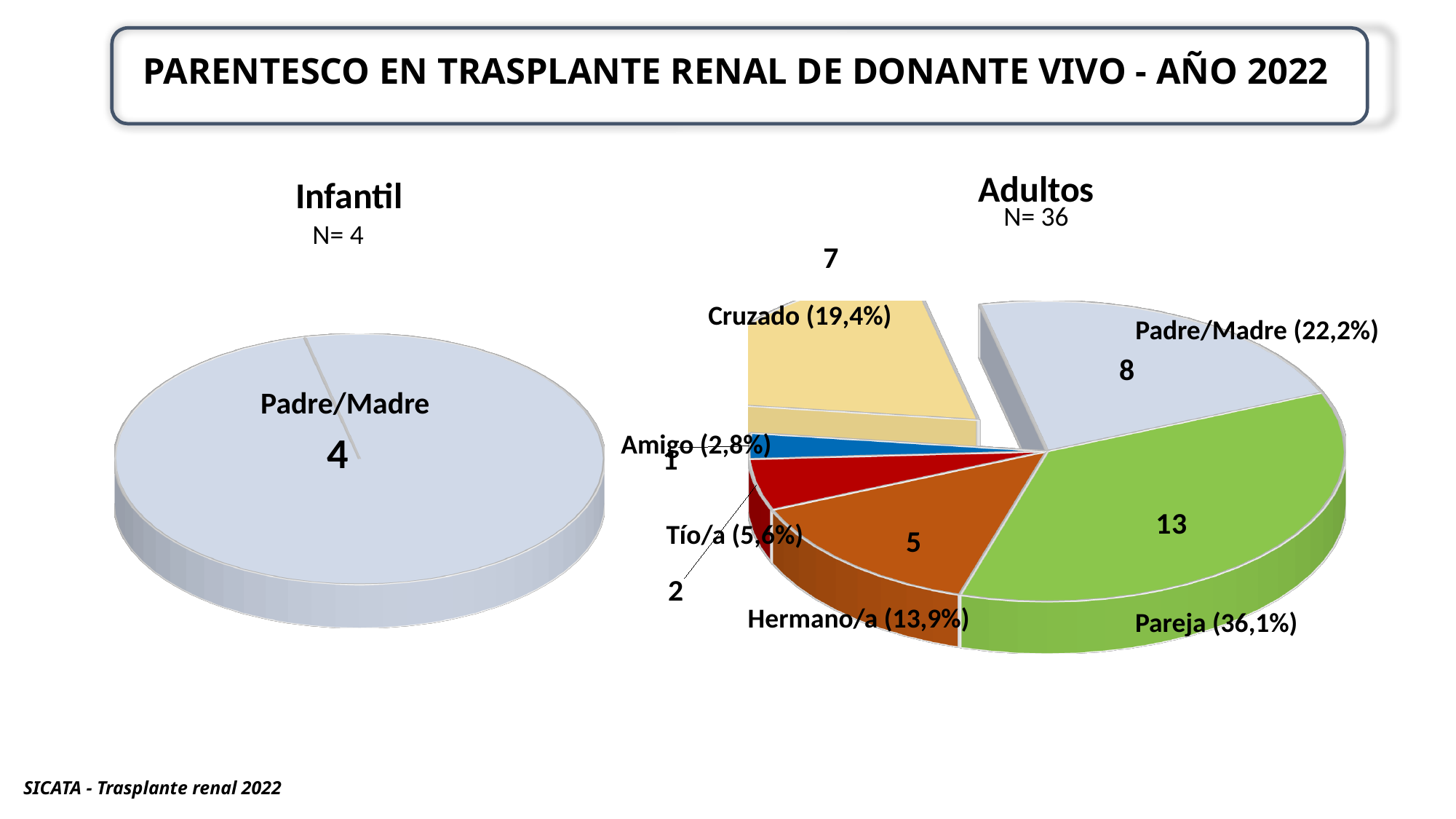
What is the N value stated for the Adultos chart? N= 36 In the Adultos pie chart, what is the difference between the values for Pareja and Padre/Madre? 5 In the Adultos pie chart, which is larger, Cruzado or Hermano/a? Cruzado What type of chart is used for the Infantil data? Pie chart In the Adultos pie chart, what is the value for Cruzado? 7 In the Adultos pie chart, which category has the largest slice? Pareja In the Adultos pie chart, what is the value for Hermano/a? 5 In the Adultos pie chart, what percentage share does Padre/Madre have? 22,2% In the Infantil pie chart, what is the value for Padre/Madre? 4 In the Adultos pie chart, which category has the smallest slice? Amigo In the Adultos pie chart, what is the value for Pareja? 13 How many categories are shown in the Adultos pie chart? 6